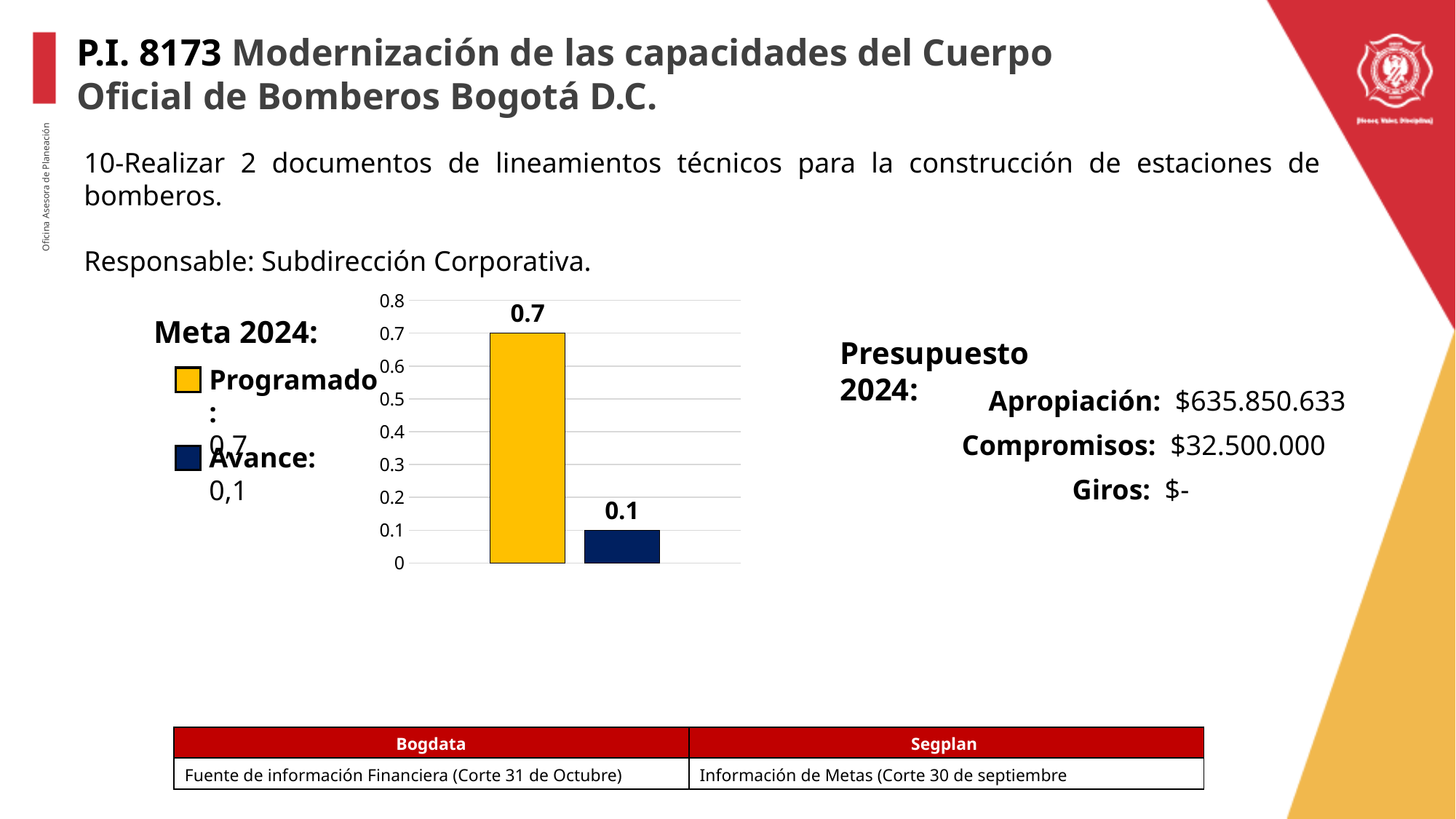
What colour is the Programado bar in the chart? yellow Which series has the highest value in the chart? Programado Which bar is higher in the chart, Programado or Avance? Programado What kind of chart is shown on the slide? bar chart Which series has the lowest value in the chart? Avance What is the value of the Programado bar in the chart? 0.7 How many bars are plotted in the chart? 2 How many series does the chart legend list? 2 What is the value of the Avance bar in the chart? 0.1 What is the maximum value shown on the chart's vertical axis? 0.8 What is the difference between the Programado and Avance values in the chart? 0.6 Is the value of the Programado bar greater or less than 0.5? greater